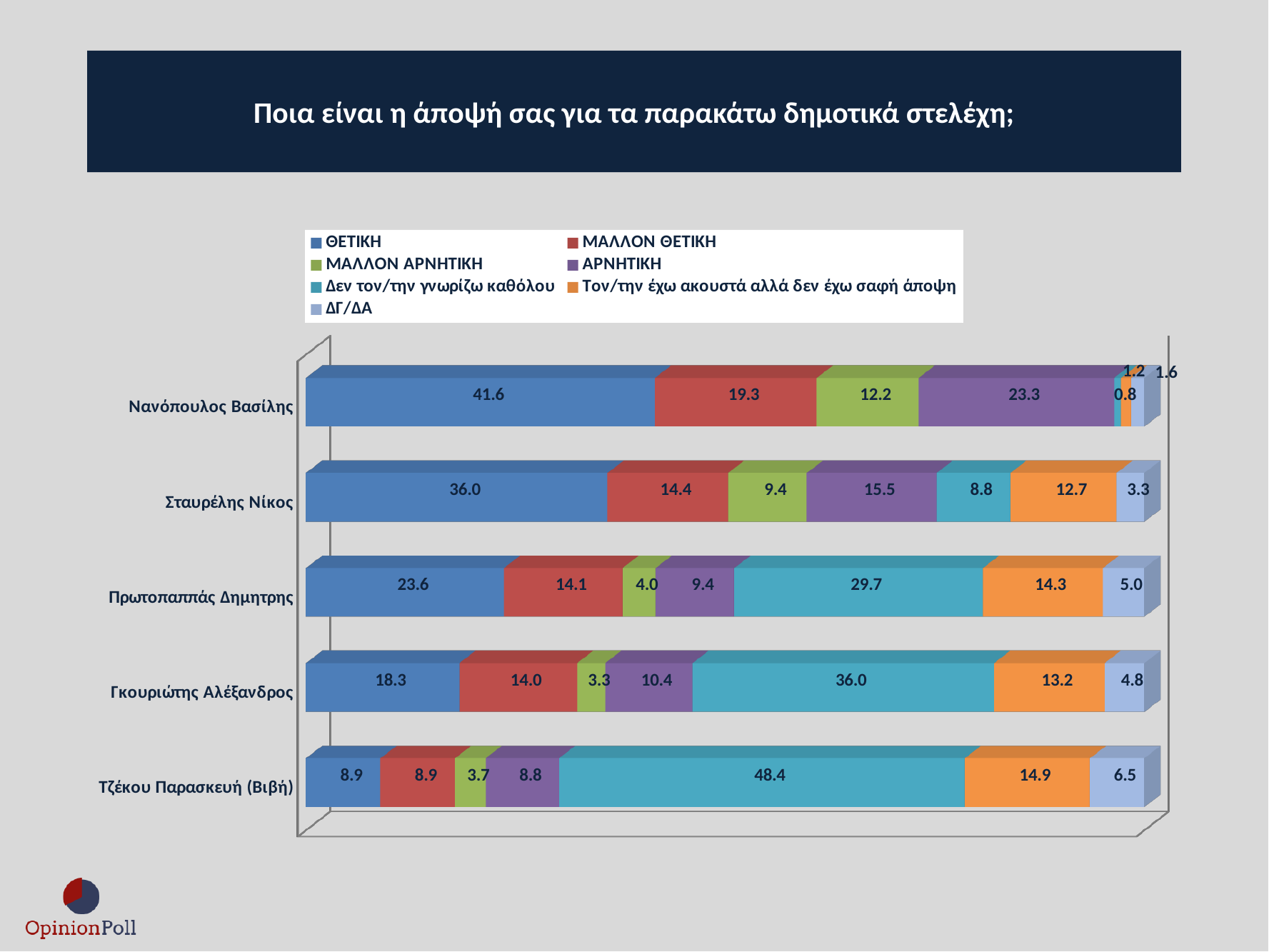
Which is larger: the ΜΑΛΛΟΝ ΘΕΤΙΚΗ value for Νανόπουλος Βασίλης or for Σταυρέλης Νίκος? Νανόπουλος Βασίλης How many series does the legend list? 7 What is the ΑΡΝΗΤΙΚΗ value for Σταυρέλης Νίκος? 15.5 What is the 'Δεν τον/την γνωρίζω καθόλου' value for Τζέκου Παρασκευή (Βιβή)? 48.4 What is the ΔΓ/ΔΑ value for Πρωτοπαππάς Δημητρης? 5.0 What kind of chart is shown on the slide? Stacked bar chart Which colour represents ΑΡΝΗΤΙΚΗ in the legend? Purple What is the difference between the ΘΕΤΙΚΗ values of Σταυρέλης Νίκος and Γκουριώτης Αλέξανδρος? 17.7 Which person has the highest ΘΕΤΙΚΗ value? Νανόπουλος Βασίλης What is the ΘΕΤΙΚΗ value for Νανόπουλος Βασίλης? 41.6 Which person has the lowest 'Δεν τον/την γνωρίζω καθόλου' value? Νανόπουλος Βασίλης How many people (categories) are shown in the chart? 5